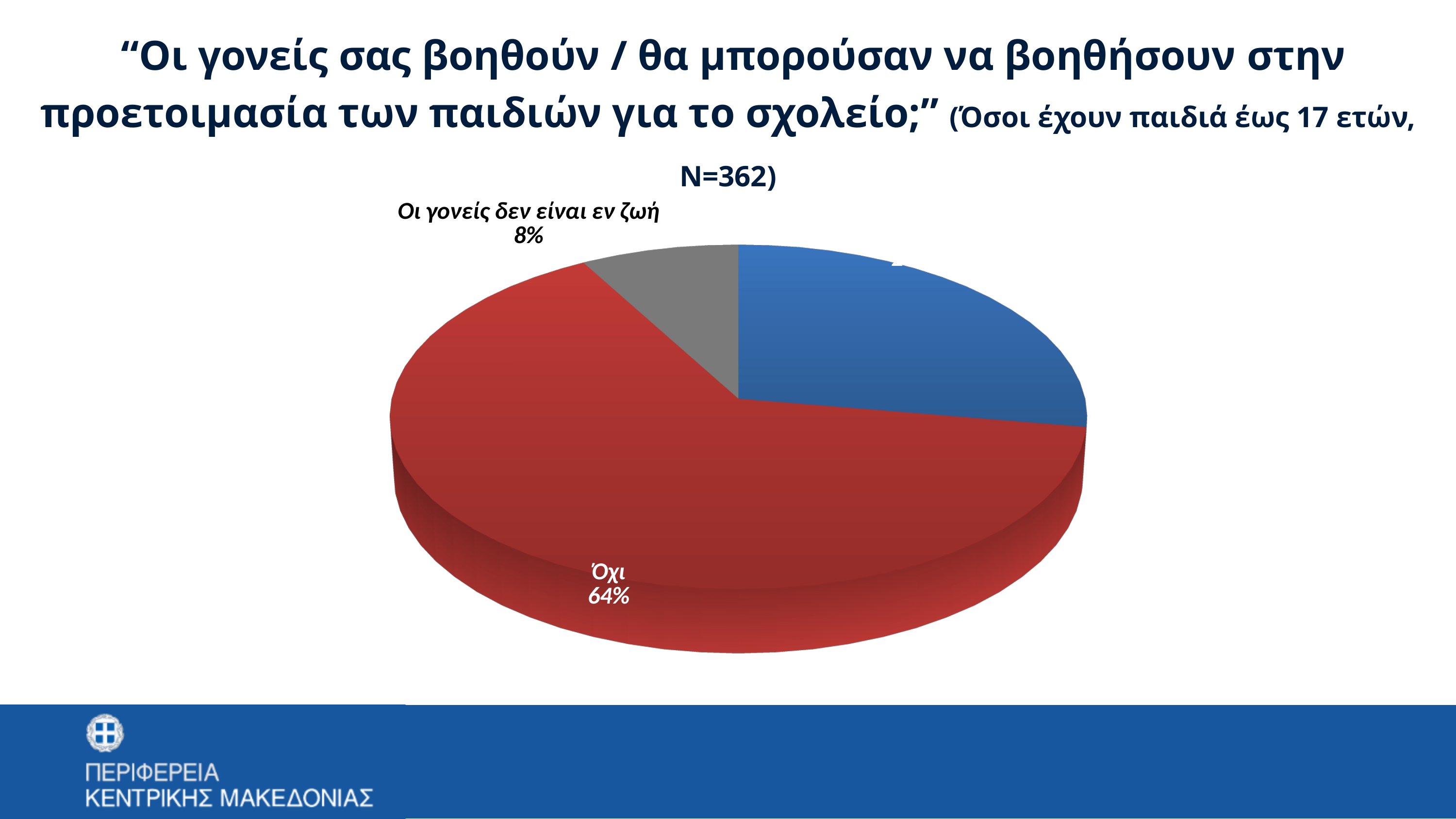
Which slice is larger, "Όχι" or "Οι γονείς δεν είναι εν ζωή"? Όχι How many slices does the pie chart have? 3 Which slice is larger, the red slice or the blue slice? the red slice (Όχι) What kind of chart is shown on the slide? pie chart What percentage of respondents answered "Οι γονείς δεν είναι εν ζωή"? 8% Which response has the smallest share of the pie? Οι γονείς δεν είναι εν ζωή What percentage of respondents answered "Όχι"? 64% What is the sample size (N) stated in the chart title? N=362 Which response has the largest share of the pie? Όχι By how many percentage points does "Όχι" exceed "Οι γονείς δεν είναι εν ζωή"? 56 percentage points What colour is the slice for "Όχι"? red